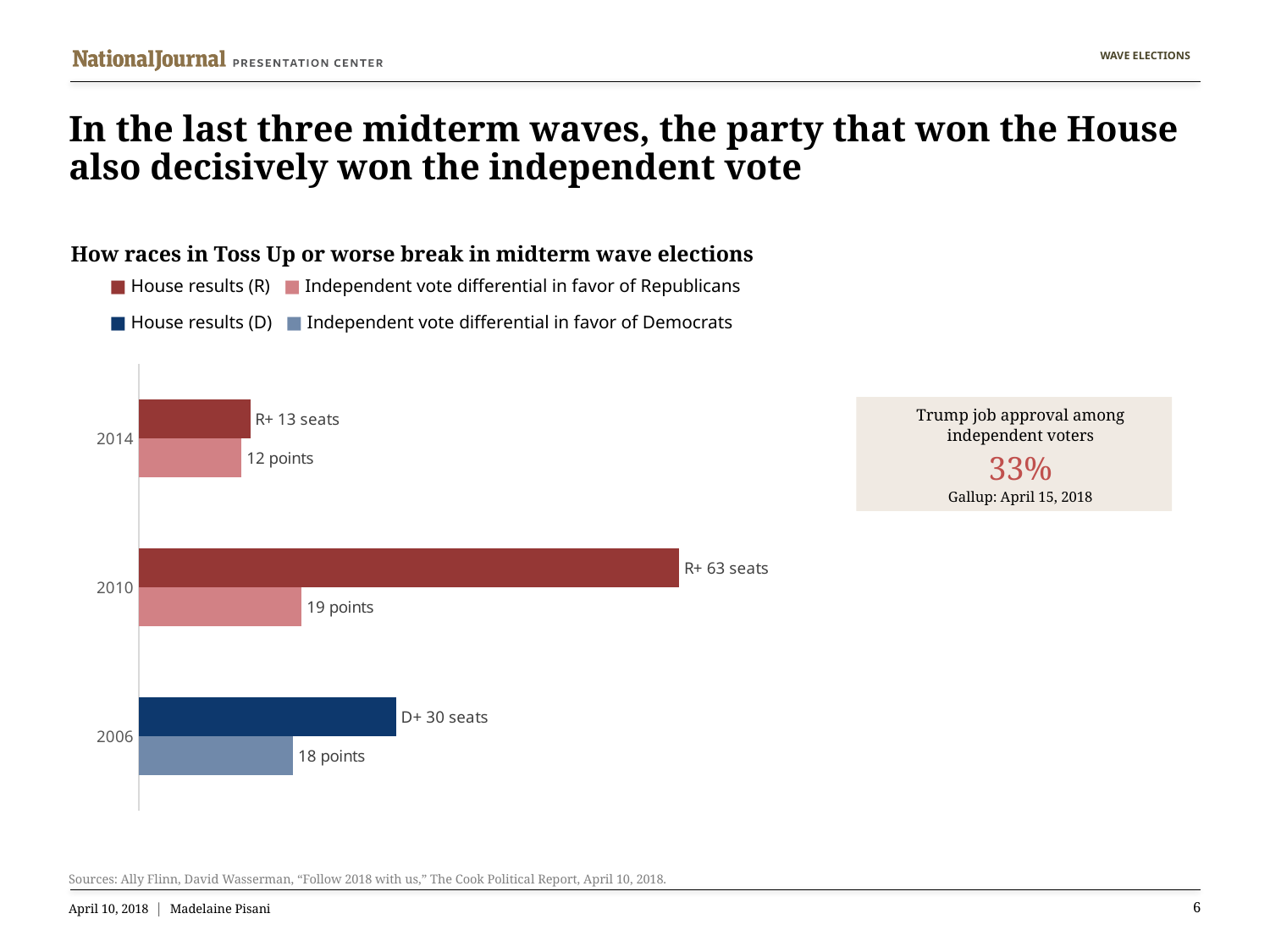
How many series does the legend list? 4 What kind of chart is shown? Bar chart Which year has the largest House seat gain shown? 2010 What is the House result label for 2010? R+ 63 seats What is the title of the chart? How races in Toss Up or worse break in midterm wave elections What is the House result label for 2014? R+ 13 seats Which year has the smallest independent vote differential? 2014 What is the difference in independent vote differential between 2010 and 2014? 7 points Which is larger: the independent vote differential in 2010 or in 2006? 2010 What is the independent vote differential for 2006? 18 points How many election years are shown on the chart? 3 What is the independent vote differential for 2014? 12 points